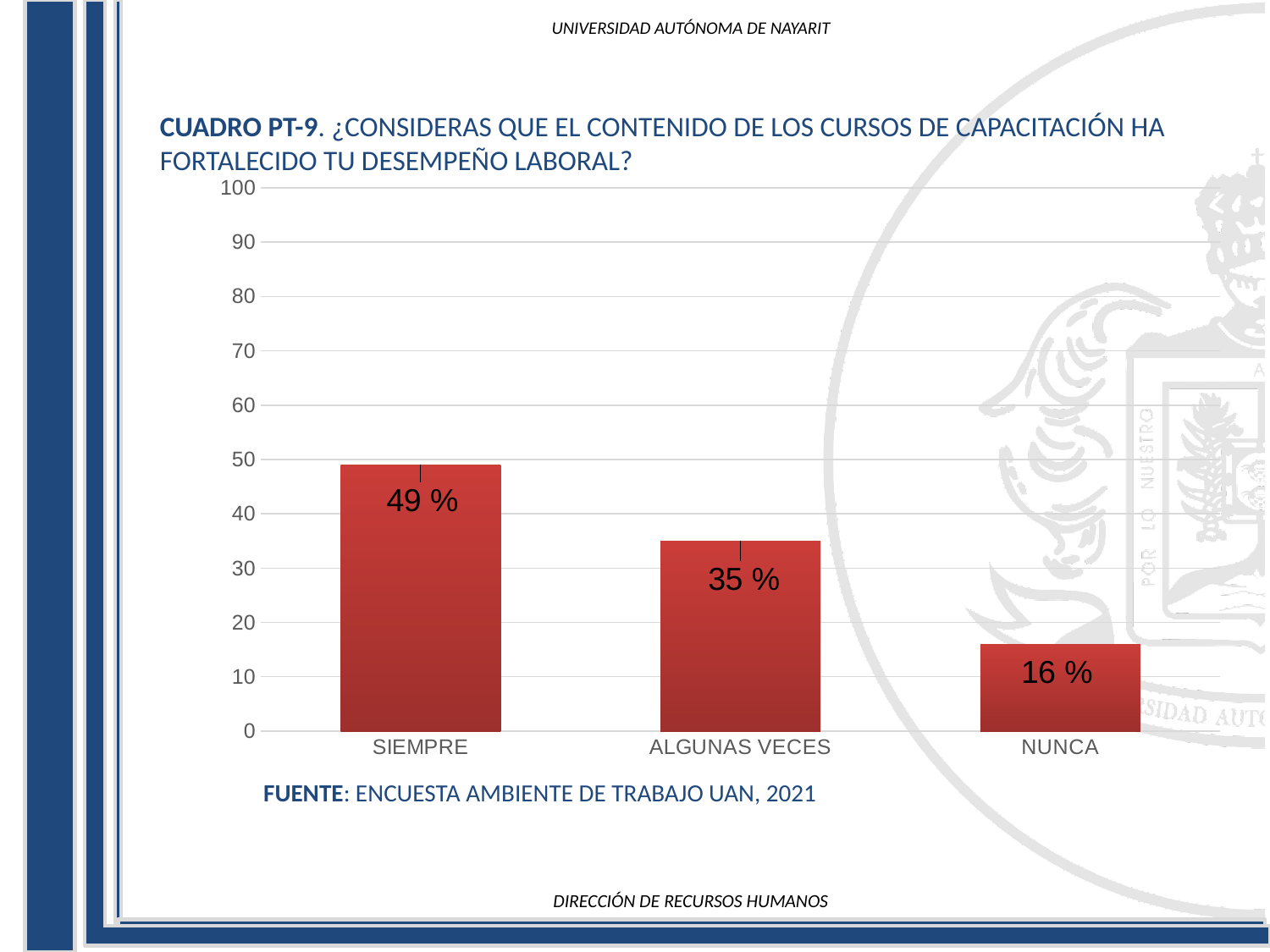
How many categories are shown on the x axis? 3 What is the value for ALGUNAS VECES? 35 % Which category has the lowest value? NUNCA Which category has the highest value? SIEMPRE What is the value for NUNCA? 16 % What is the difference between the values for SIEMPRE and ALGUNAS VECES? 14 % Which is larger, the value for ALGUNAS VECES or the value for NUNCA? ALGUNAS VECES What is the value for SIEMPRE? 49 % Is the value for SIEMPRE greater or less than 40? greater Do the values rise or fall from left to right along the x axis? fall What is the difference between the values for ALGUNAS VECES and NUNCA? 19 % What kind of chart is shown on the slide? bar chart